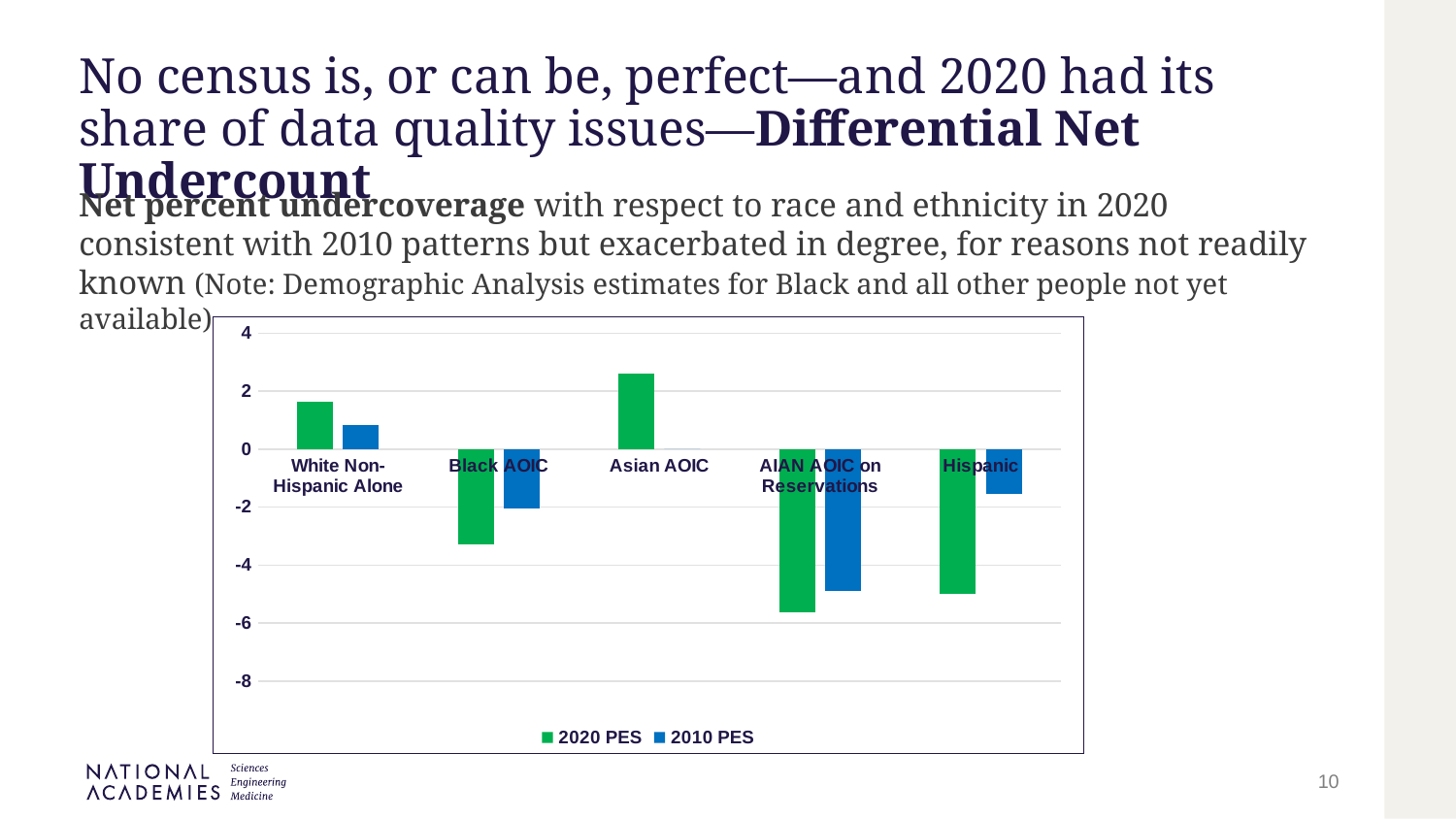
Which colour represents the 2020 PES series in the chart? Green Which category has the highest 2020 PES value? Asian AOIC Is the 2010 PES value for Hispanic greater or less than -2? greater What kind of chart is shown on the slide? Bar chart Is the 2020 PES value for Asian AOIC greater or less than 2? greater Which category has the lowest 2010 PES value? AIAN AOIC on Reservations How many series does the chart's legend list? 2 Is the 2020 PES value for AIAN AOIC on Reservations greater or less than -4? less For White Non-Hispanic Alone, which is larger: the 2020 PES value or the 2010 PES value? 2020 PES How many race/ethnicity categories are shown on the x axis of the chart? 5 For Hispanic, which is larger: the 2020 PES value or the 2010 PES value? 2010 PES Which category has the highest 2010 PES value? White Non-Hispanic Alone